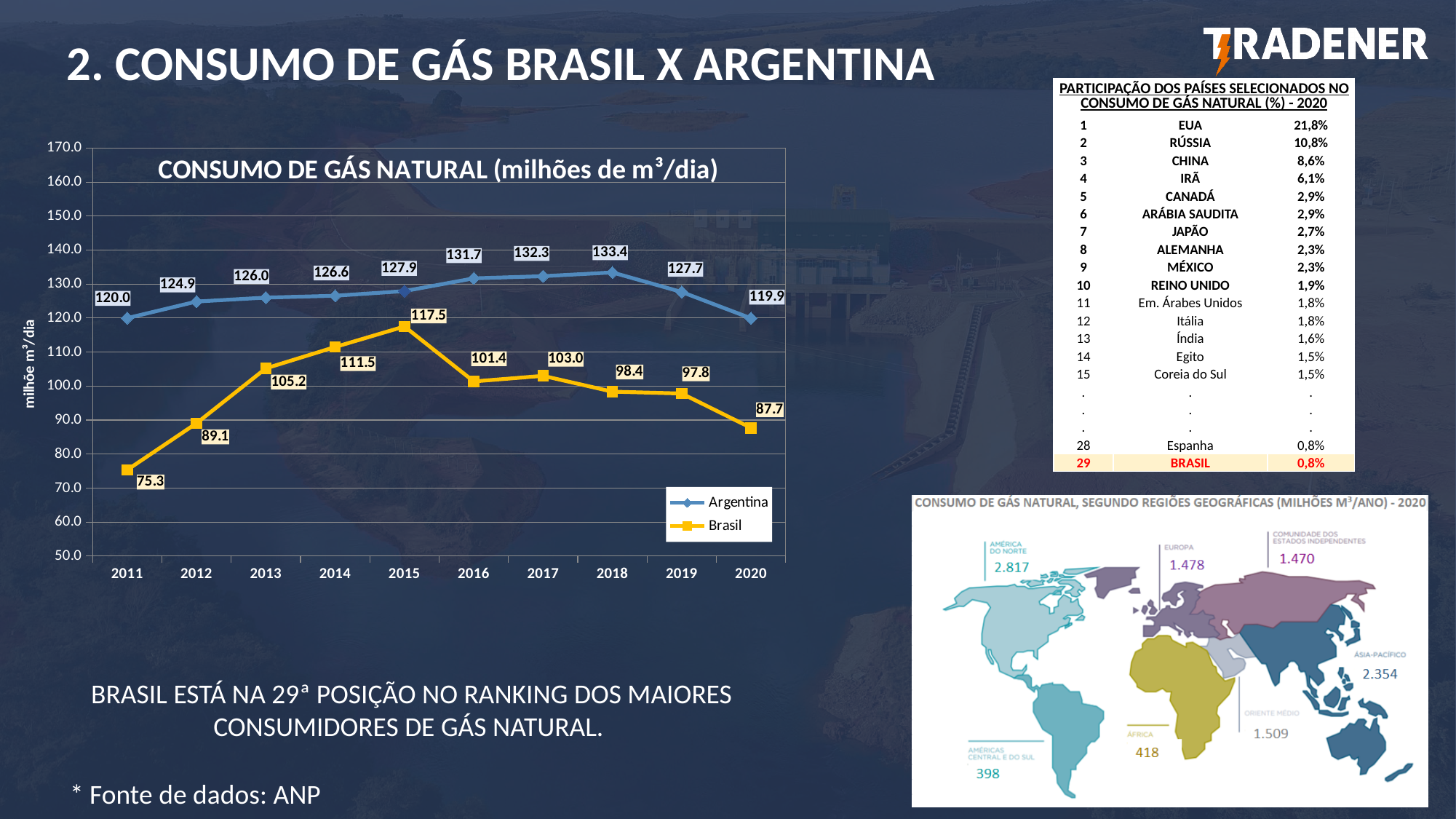
How many years are shown on the x axis of the natural gas consumption chart? 10 What is the title of the line chart on the slide? CONSUMO DE GÁS NATURAL (milhões de m³/dia) What is the difference between Argentina's and Brasil's natural gas consumption in 2020? 32.2 In which year did Argentina have its highest natural gas consumption? 2018 Which series had the higher value in 2013, Argentina or Brasil? Argentina In which year did Brasil have its lowest natural gas consumption? 2011 By how much did Brasil's natural gas consumption change from 2011 to 2012? 13.8 What was Brasil's natural gas consumption in 2015? 117.5 Did Brasil's natural gas consumption rise or fall from 2015 to 2020? fall What type of chart is used to show natural gas consumption for Argentina and Brasil? line chart What was Argentina's natural gas consumption in 2018? 133.4 How many series does the legend of the natural gas consumption chart list? 2